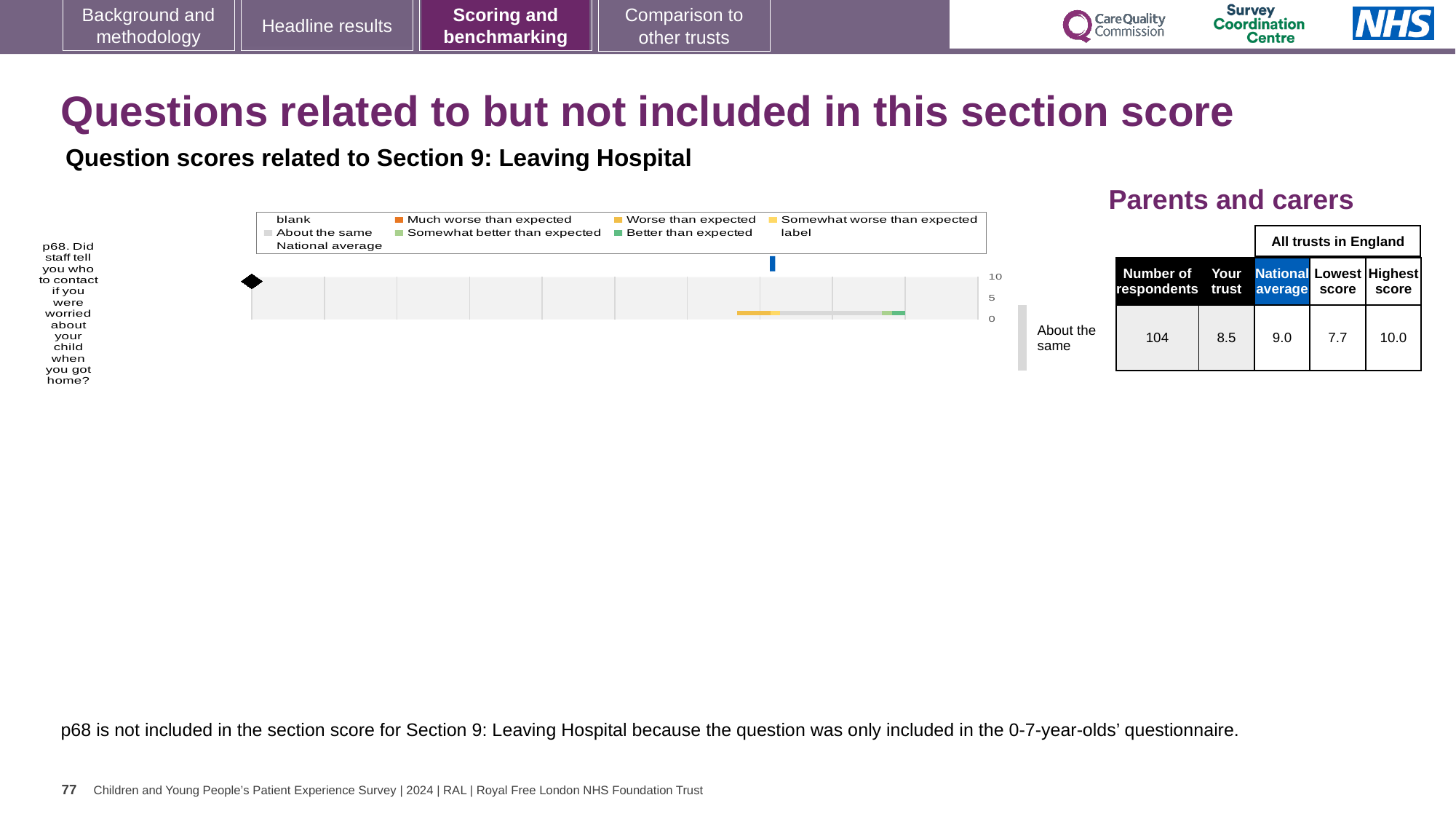
What is the 'Your trust' score for question p68? 8.5 What kind of chart is shown for question p68? bar chart What is the lowest score among all trusts in England for question p68? 7.7 How many respondents answered question p68? 104 How is the trust's result for question p68 categorised relative to expectations? About the same What is the highest score among all trusts in England for question p68? 10.0 Which legend entry is shown with a blue marker in the chart? National average What is the difference between the national average and the trust's score for question p68? 0.5 Which is larger for question p68, the trust's score or the national average? national average How many questions are plotted in the chart? 1 What is the highest tick value shown on the chart's axis? 10 What is the national average score for question p68? 9.0